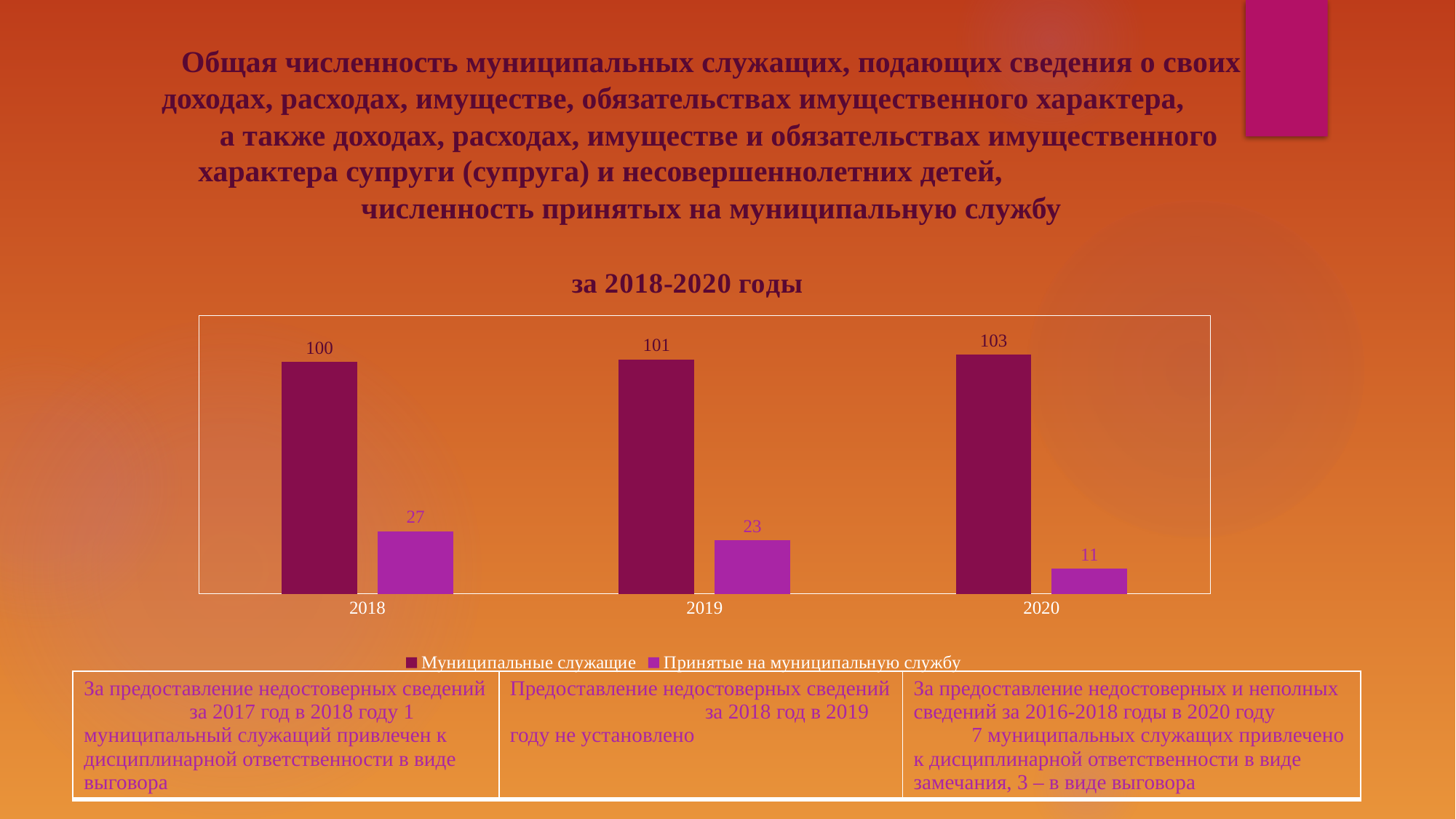
Does the value for Муниципальные служащие rise or fall from 2018 to 2020? rise What is the value for Принятые на муниципальную службу in 2019? 23 What is the value for Принятые на муниципальную службу in 2020? 11 What kind of chart is shown on the slide? bar chart By how much did Принятые на муниципальную службу decrease from 2018 to 2020? 16 How many series does the legend list? 2 In which year is the value for Муниципальные служащие highest? 2020 What is the difference between Муниципальные служащие and Принятые на муниципальную службу in 2018? 73 How many years are shown on the x axis? 3 What is the value for Муниципальные служащие in 2018? 100 In which year is the value for Принятые на муниципальную службу lowest? 2020 Which is larger: Принятые на муниципальную службу in 2018 or in 2019? 2018